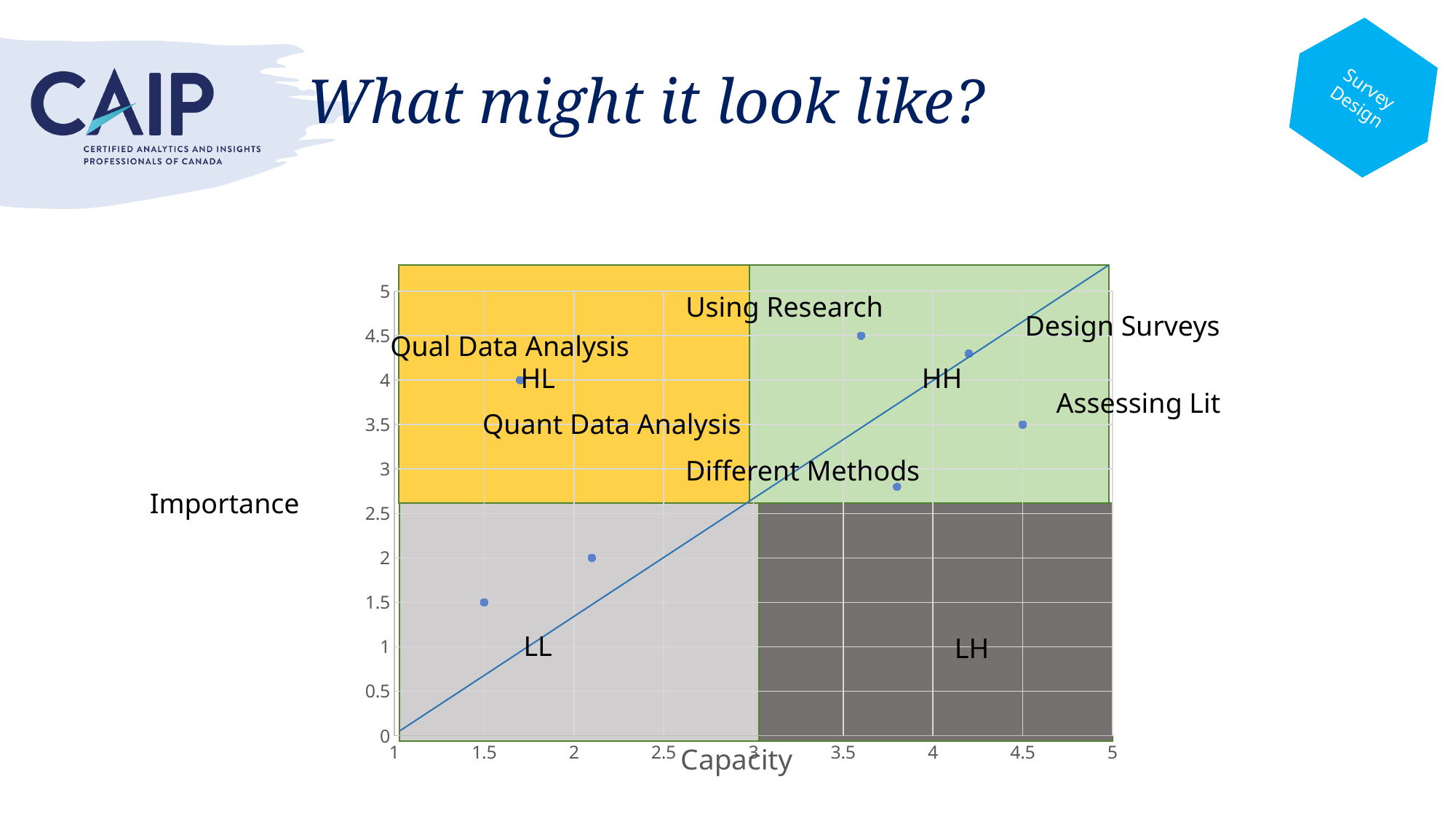
Is the Importance value for Different Methods greater or less than 3? less Is the Capacity value for Design Surveys greater or less than 4? greater What kind of chart is shown on the slide? scatter chart What is the label of the horizontal axis of the chart? Capacity Is the Capacity value for Qual Data Analysis greater or less than 2? less How many data points are plotted on the chart? 7 Which has the higher Importance value, Using Research or Assessing Lit? Using Research Which labeled point has the highest Capacity value? Assessing Lit Which labeled point has the highest Importance value? Using Research What is the label of the vertical axis of the chart? Importance